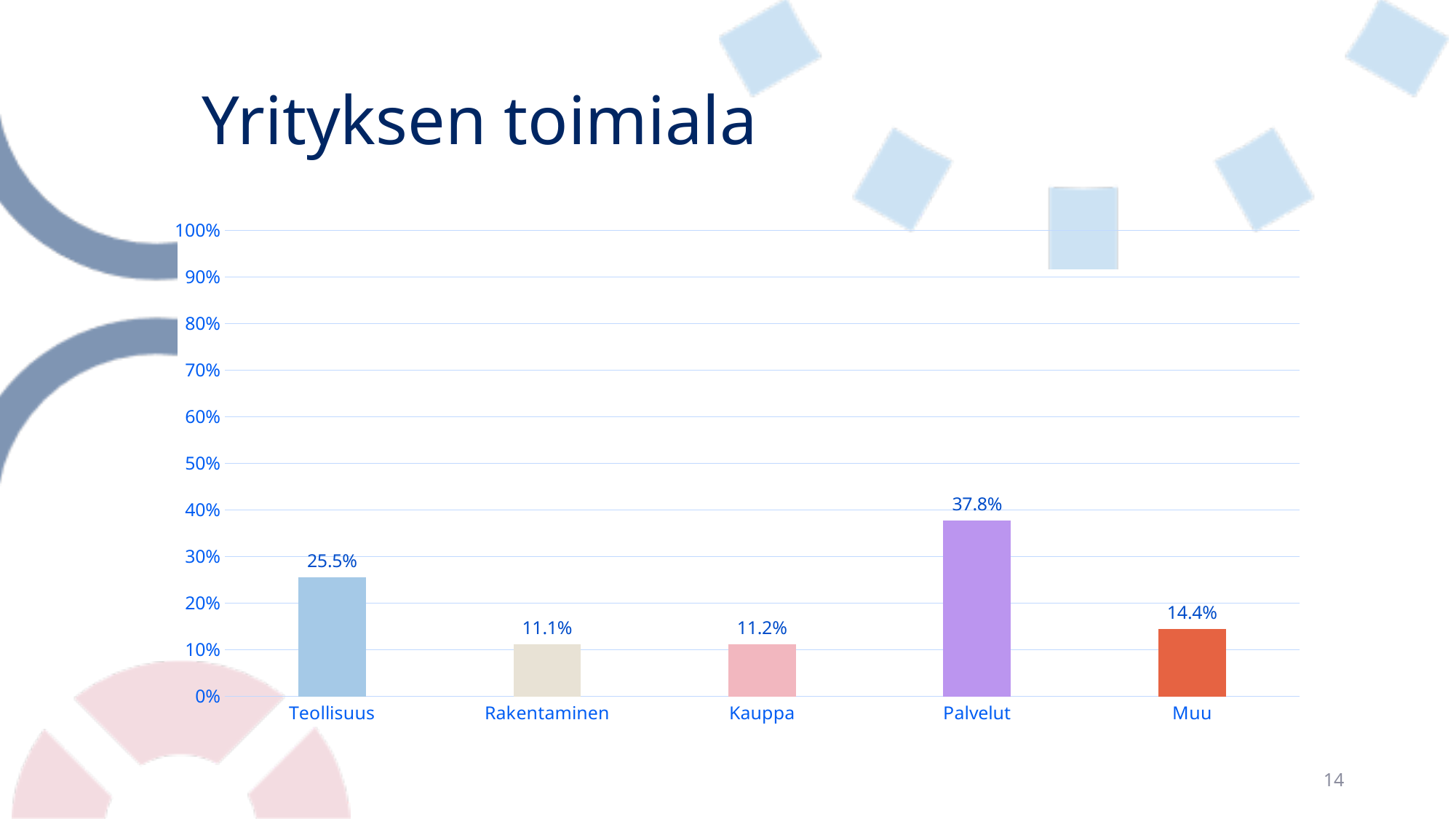
How many categories are shown on the x axis? 5 What is the value for Muu? 14.4% What is the value for Palvelut? 37.8% What is the value for Teollisuus? 25.5% Is the value for Palvelut greater or less than 30%? greater Which is larger, the value for Teollisuus or the value for Muu? Teollisuus What is the difference between the values for Muu and Kauppa? 3.2% What kind of chart is shown on the slide? bar chart Which category has the lowest value? Rakentaminen Which category has the highest value? Palvelut What is the difference between the values for Palvelut and Teollisuus? 12.3% What is the title of the slide? Yrityksen toimiala